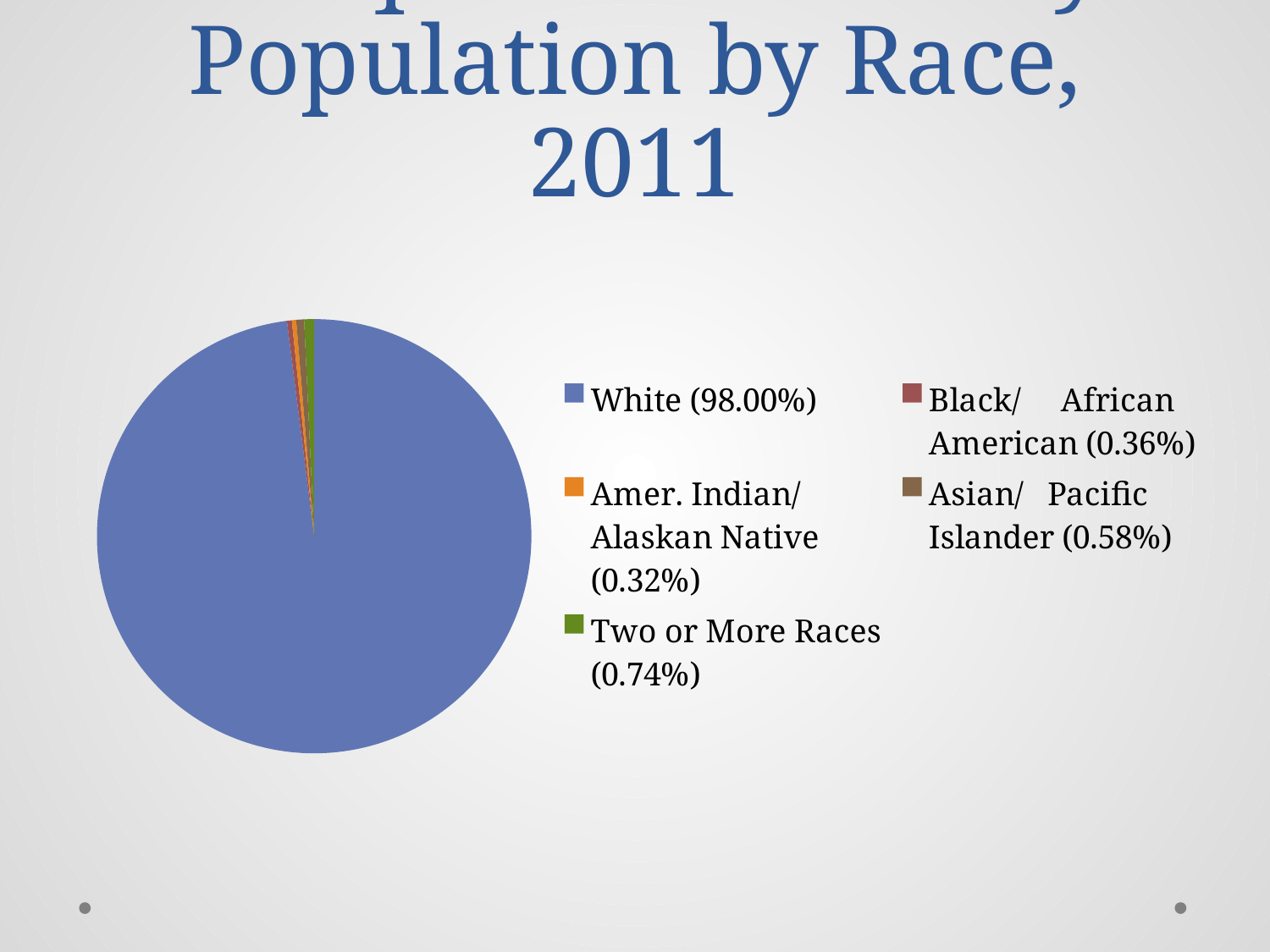
What colour is the slice representing White? blue Which is larger, the share for Two or More Races or the share for Asian/Pacific Islander? Two or More Races What is the difference in percentage points between Two or More Races and Asian/Pacific Islander? 0.16% What percentage is shown for Two or More Races? 0.74% What percentage is shown for Black/African American? 0.36% What kind of chart is shown on the slide? pie chart Which race category has the smallest share of the pie? Amer. Indian/Alaskan Native What percentage is shown for Asian/Pacific Islander? 0.58% What percentage is shown for Amer. Indian/Alaskan Native? 0.32% Which race category has the largest share of the pie? White How many categories does the pie chart show? 5 What percentage of the population is White according to the legend? 98.00%